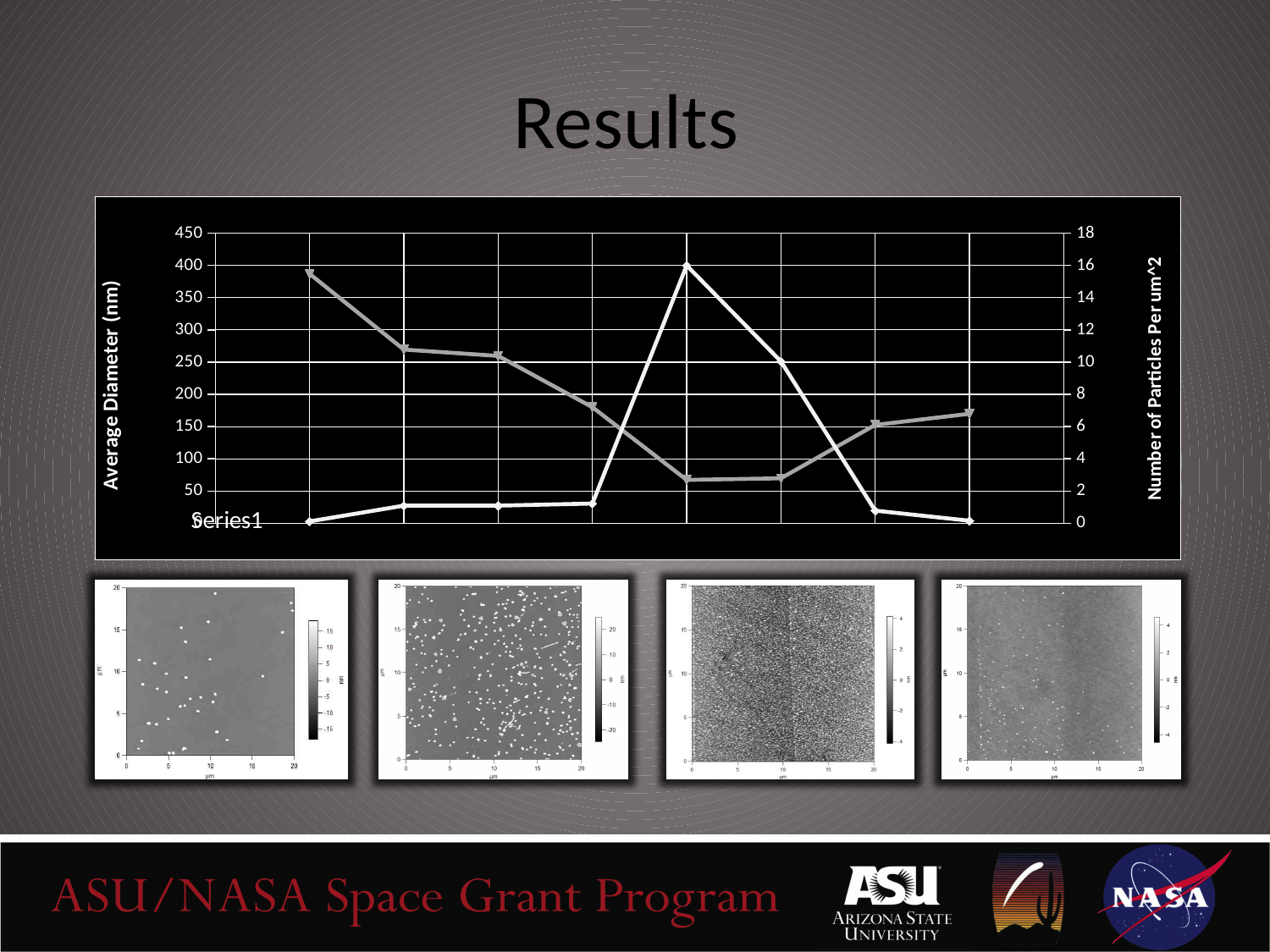
Which point of the gray line is the highest: the first, the fourth, or the last? the first Reading against the left axis, is the sixth point of the gray line greater or less than 100? less Reading against the left axis, is the fourth point of the gray line greater or less than 200? less Which point of the white line is the highest: the first, the fifth, or the last? the fifth Reading against the right axis, is the highest point of the white line greater or less than 14? greater What kind of chart is shown on the slide? line chart What is the title of the right vertical axis of the chart? Number of Particles Per um^2 What is the title of the left vertical axis of the chart? Average Diameter (nm) Does the gray line rise or fall from its first point to its fourth point? fall How many data points does the gray line in the chart have? 8 How many data series are plotted in the line chart? 2